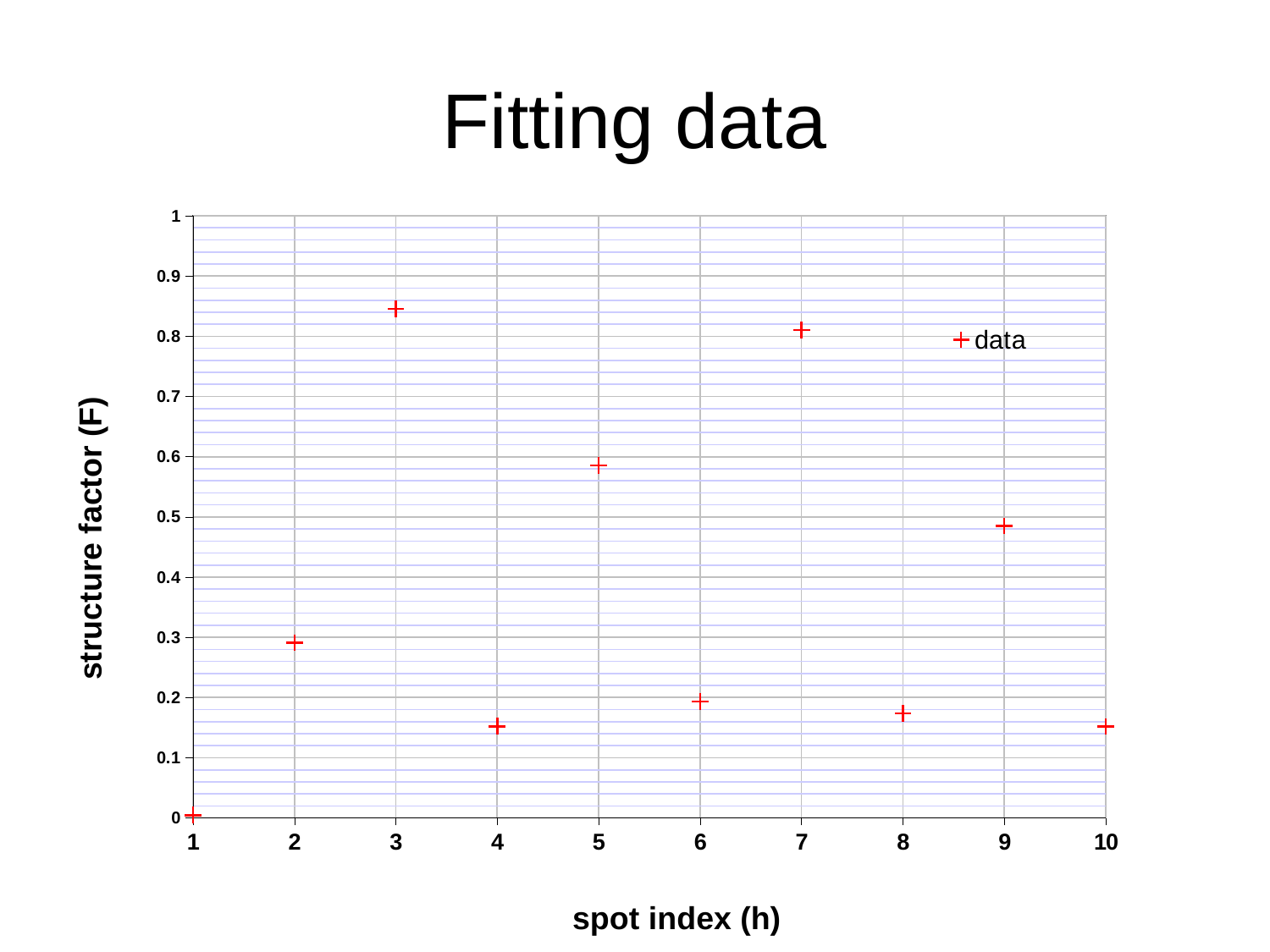
How many data points are plotted in the chart? 10 Which spot index has the highest structure factor (F)? 3 What is the label of the x axis? spot index (h) Is the structure factor for spot index 3 greater or less than 0.8? greater Which spot index has the lowest structure factor (F)? 1 Is the structure factor for spot index 7 greater or less than 0.7? greater Which has a larger structure factor, spot index 5 or spot index 9? 5 Is the structure factor for spot index 4 greater or less than 0.2? less How many series does the legend list? 1 What kind of chart is shown on the slide? scatter chart What is the title of the chart? Fitting data